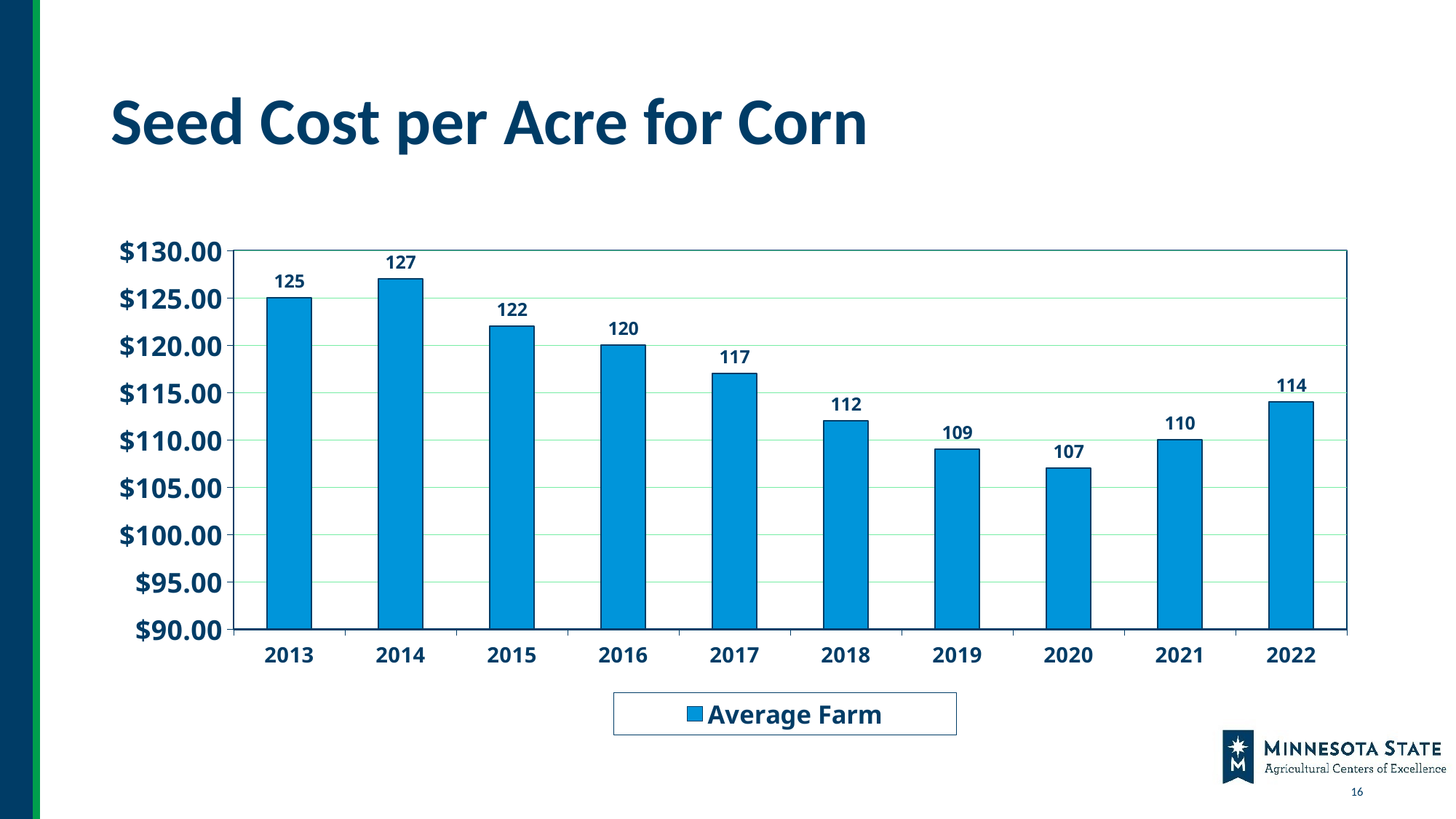
Which year has a higher seed cost per acre, 2017 or 2021? 2017 What is the seed cost per acre for corn in 2020? 107 Is the value for 2018 greater or less than $110.00? greater How many series does the legend list? 1 Which year has the highest seed cost per acre for corn? 2014 What is the name of the series shown in the legend? Average Farm What kind of chart is shown on the slide? bar chart What is the seed cost per acre for corn in 2022? 114 What is the seed cost per acre for corn in 2014? 127 How many years are shown on the x axis of the chart? 10 What is the difference between the seed cost per acre in 2014 and in 2020? 20 Which year has the lowest seed cost per acre for corn? 2020